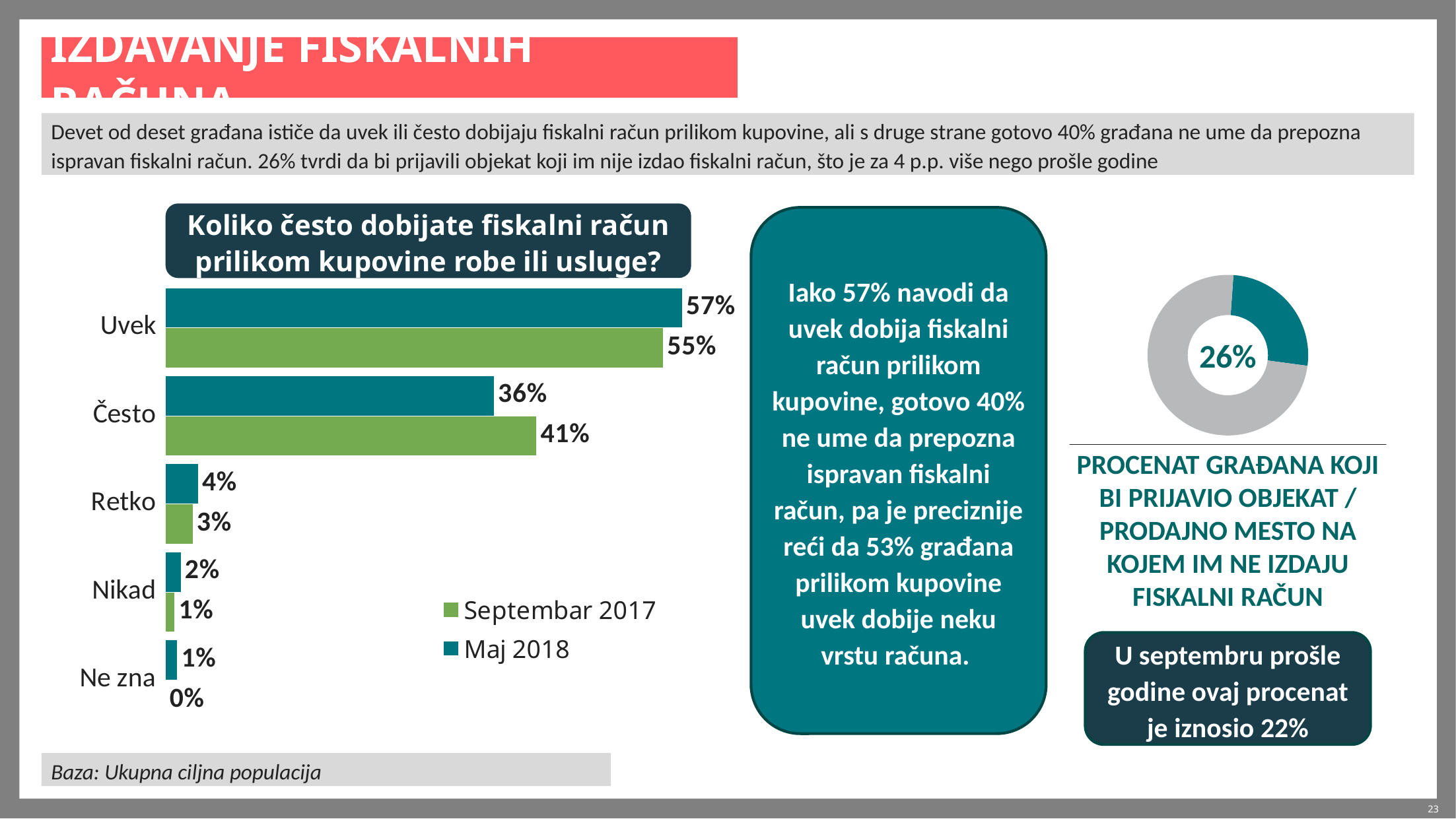
How many series does the legend of the bar chart 'Koliko često dobijate fiskalni račun prilikom kupovine robe ili usluge?' list? 2 In the bar chart 'Koliko često dobijate fiskalni račun prilikom kupovine robe ili usluge?', what is the value for Retko in Maj 2018? 4% In the bar chart 'Koliko često dobijate fiskalni račun prilikom kupovine robe ili usluge?', which is larger for Uvek: Septembar 2017 or Maj 2018? Maj 2018 In the donut chart on the right of the slide, what percentage is shown in the centre? 26% In the bar chart 'Koliko često dobijate fiskalni račun prilikom kupovine robe ili usluge?', what is the value for Uvek in Maj 2018? 57% How many categories are shown in the bar chart 'Koliko često dobijate fiskalni račun prilikom kupovine robe ili usluge?'? 5 In the bar chart 'Koliko često dobijate fiskalni račun prilikom kupovine robe ili usluge?', what is the difference between the Septembar 2017 and Maj 2018 values for Često? 5% In the bar chart 'Koliko često dobijate fiskalni račun prilikom kupovine robe ili usluge?', which category has the highest value for Maj 2018? Uvek In the bar chart 'Koliko često dobijate fiskalni račun prilikom kupovine robe ili usluge?', which category has the lowest value for Septembar 2017? Ne zna In the bar chart 'Koliko često dobijate fiskalni račun prilikom kupovine robe ili usluge?', what is the value for Često in Septembar 2017? 41% In the bar chart 'Koliko često dobijate fiskalni račun prilikom kupovine robe ili usluge?', what is the value for Ne zna in Septembar 2017? 0% What kind of chart is the chart titled 'Koliko često dobijate fiskalni račun prilikom kupovine robe ili usluge?'? Bar chart